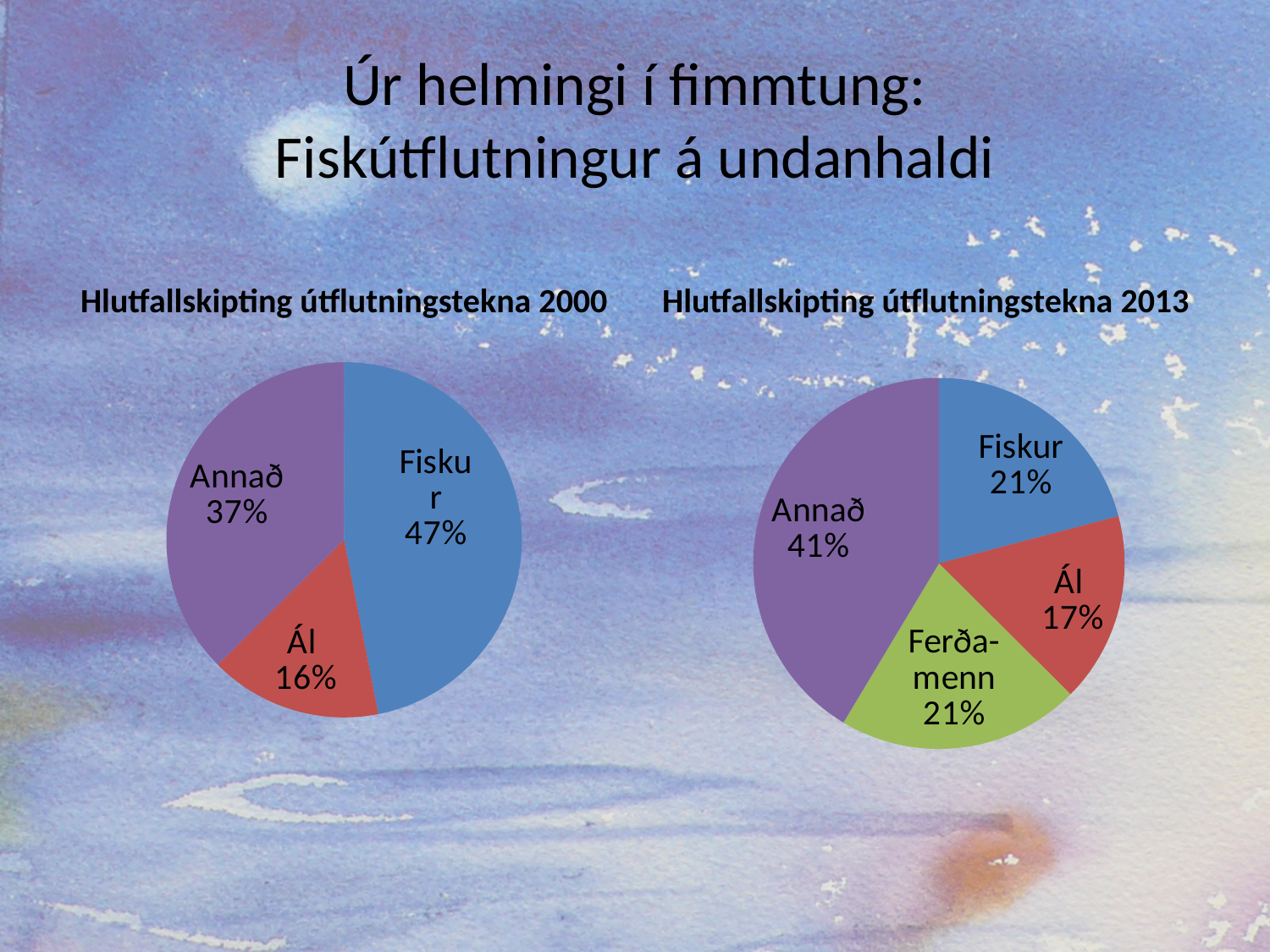
In the chart titled "Hlutfallskipting útflutningstekna 2000", what share does Fiskur have? 47% In the chart titled "Hlutfallskipting útflutningstekna 2013", what share does Annað have? 41% In the chart titled "Hlutfallskipting útflutningstekna 2000", what share does Ál have? 16% What is the difference between the Fiskur share in the 2000 chart and the Fiskur share in the 2013 chart? 26 percentage points In the chart titled "Hlutfallskipting útflutningstekna 2013", which category has the smallest slice? Ál What type of chart is used for "Hlutfallskipting útflutningstekna 2000"? Pie chart In the chart titled "Hlutfallskipting útflutningstekna 2013", what share does Ferðamenn have? 21% How many slices does the chart titled "Hlutfallskipting útflutningstekna 2013" have? 4 In the chart titled "Hlutfallskipting útflutningstekna 2000", which category has the smallest slice? Ál How many slices does the chart titled "Hlutfallskipting útflutningstekna 2000" have? 3 In the chart titled "Hlutfallskipting útflutningstekna 2000", which category has the largest slice? Fiskur In the chart titled "Hlutfallskipting útflutningstekna 2013", which is larger, Annað or Fiskur? Annað